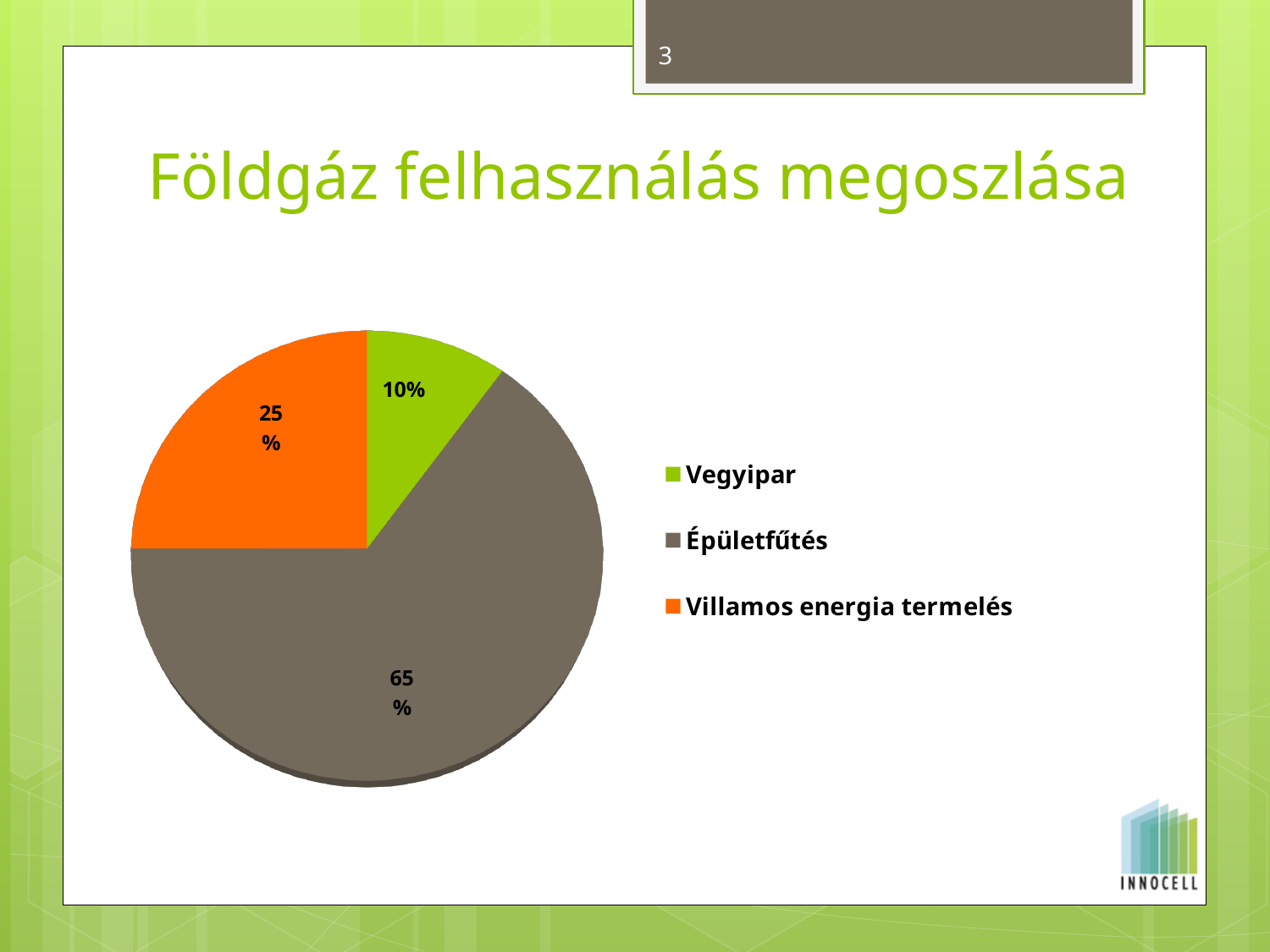
What colour is the slice for Villamos energia termelés? orange What share of the pie does Vegyipar have? 10% What share of the pie does Villamos energia termelés have? 25% Which category has the smallest slice of the pie? Vegyipar How many categories does the pie chart have? 3 What type of chart is shown on the slide? pie chart Which category has the largest slice of the pie? Épületfűtés What is the difference between the shares of Villamos energia termelés and Vegyipar? 15% What is the difference between the shares of Épületfűtés and Villamos energia termelés? 40% Which is larger, the share of Villamos energia termelés or the share of Vegyipar? Villamos energia termelés What is the title of the slide containing the chart? Földgáz felhasználás megoszlása What share of the pie does Épületfűtés have? 65%